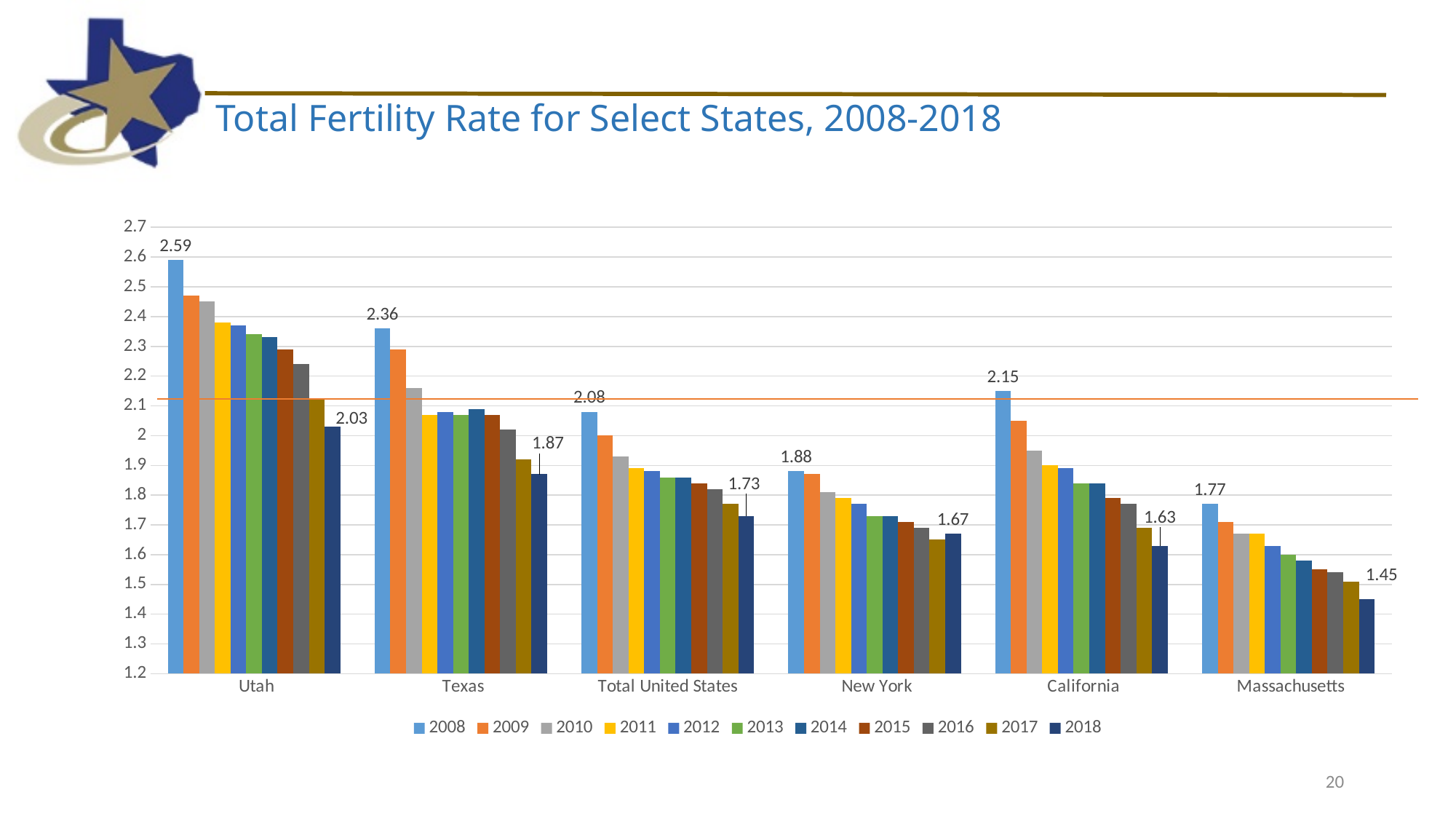
Which was higher in 2018, the total fertility rate for New York or for California? New York Is the 2010 total fertility rate for Texas greater or less than 2.1? greater What was Utah's total fertility rate in 2008? 2.59 Which state or region had the highest total fertility rate in 2008? Utah How many years (series) does the legend list? 11 Which state or region had the lowest total fertility rate in 2018? Massachusetts What is the difference between California's 2008 and 2018 total fertility rates? 0.52 What was Massachusetts's total fertility rate in 2018? 1.45 Does the total fertility rate for Total United States rise or fall from 2008 to 2018? fall How many states or regions are shown on the x axis? 6 What was the total fertility rate for Texas in 2018? 1.87 By how much did Utah's total fertility rate fall from 2008 to 2018? 0.56